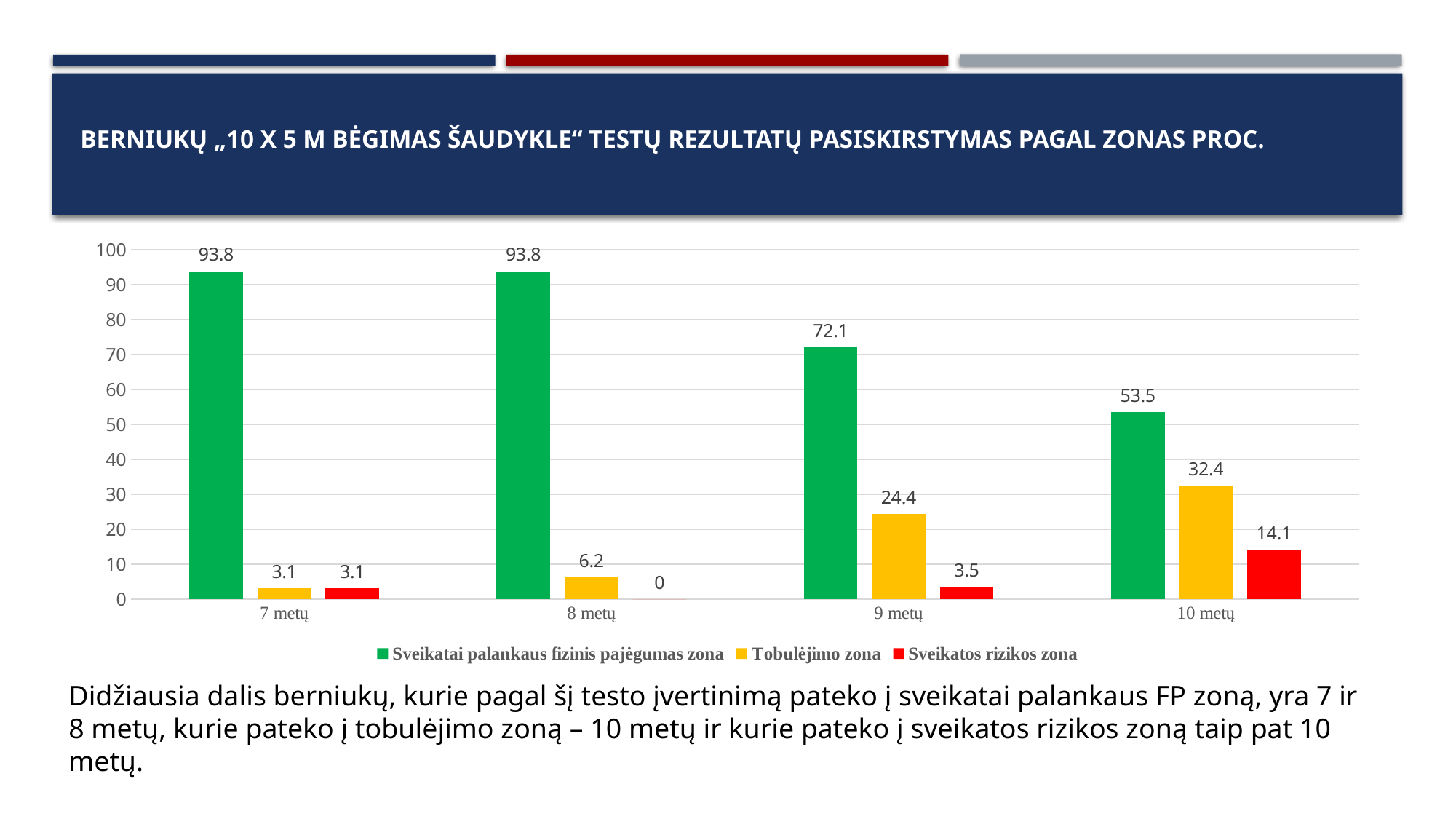
What kind of chart is shown on the slide? bar chart Is the value for 'Sveikatai palankaus fizinis pajėgumas zona' for 10 metų greater or less than 50? greater How many age groups are shown on the x axis? 4 Which age group has the highest value for 'Sveikatos rizikos zona'? 10 metų Which age group has the lowest value for 'Sveikatai palankaus fizinis pajėgumas zona'? 10 metų What is the value for 'Sveikatai palankaus fizinis pajėgumas zona' for 9 metų? 72.1 Which is larger: 'Tobulėjimo zona' for 9 metų or 'Sveikatos rizikos zona' for 10 metų? Tobulėjimo zona for 9 metų How many series does the legend list? 3 What is the value for 'Tobulėjimo zona' for 10 metų? 32.4 Do the values for 'Tobulėjimo zona' rise or fall from 7 metų to 10 metų? rise What is the value for 'Sveikatos rizikos zona' for 8 metų? 0 What is the difference between the 'Sveikatai palankaus fizinis pajėgumas zona' values for 8 metų and 9 metų? 21.7